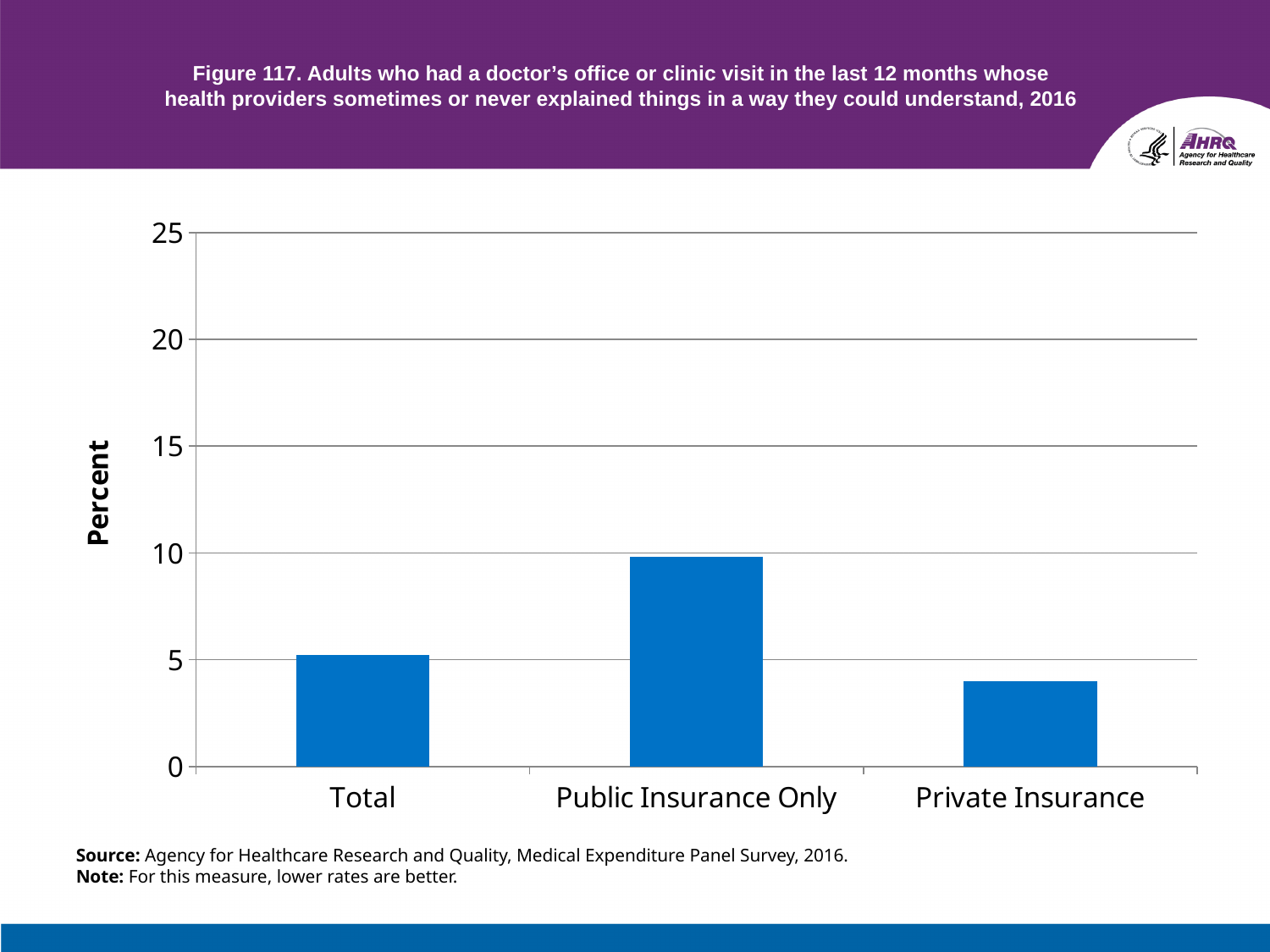
What is the maximum value shown on the y axis of the chart? 25 What kind of chart is shown on the slide? bar chart Is the value for Total greater or less than 10? less Is the value for Private Insurance greater or less than 5? less Is the value for Public Insurance Only greater or less than 15? less Which is larger, the value for Public Insurance Only or the value for Private Insurance? Public Insurance Only How many categories are shown on the x axis of the chart? 3 Which category has the lowest value? Private Insurance Which is larger, the value for Total or the value for Public Insurance Only? Public Insurance Only Which category has the highest value? Public Insurance Only What is the label on the y axis of the chart? Percent